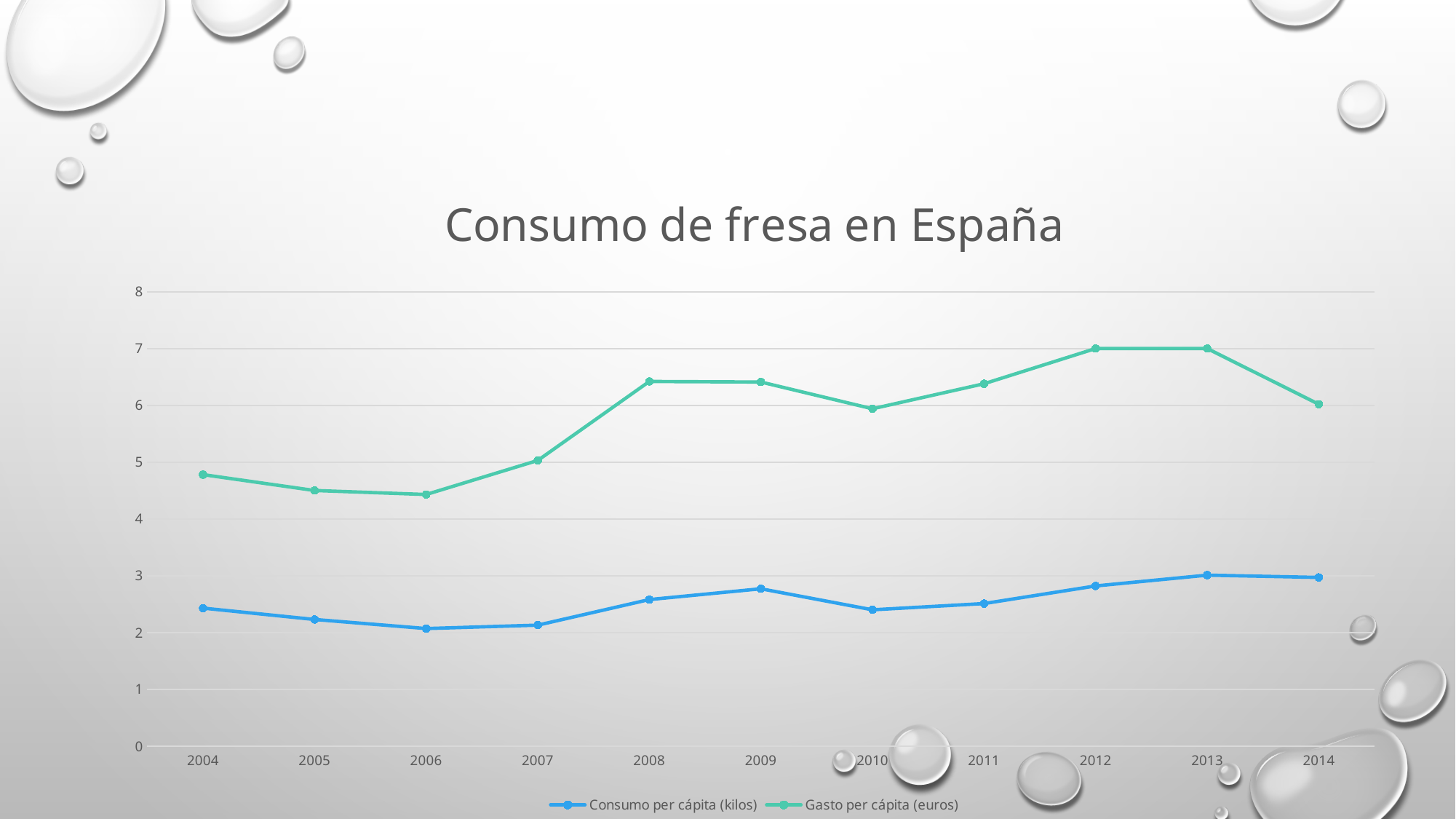
Which is larger, Gasto per cápita (euros) in 2013 or in 2014? 2013 How many years are shown on the x axis? 11 Is the value for Consumo per cápita (kilos) in 2009 greater or less than 3? less In which year is Consumo per cápita (kilos) lowest? 2006 In which year is Consumo per cápita (kilos) highest? 2013 How many series does the legend list? 2 In which year is Gasto per cápita (euros) lowest? 2006 Is the value for Gasto per cápita (euros) in 2005 greater or less than 5? less What is the title of the chart? Consumo de fresa en España What type of chart is shown on the slide? line chart Is the value for Gasto per cápita (euros) in 2008 greater or less than 6? greater Which series is shown in green? Gasto per cápita (euros)